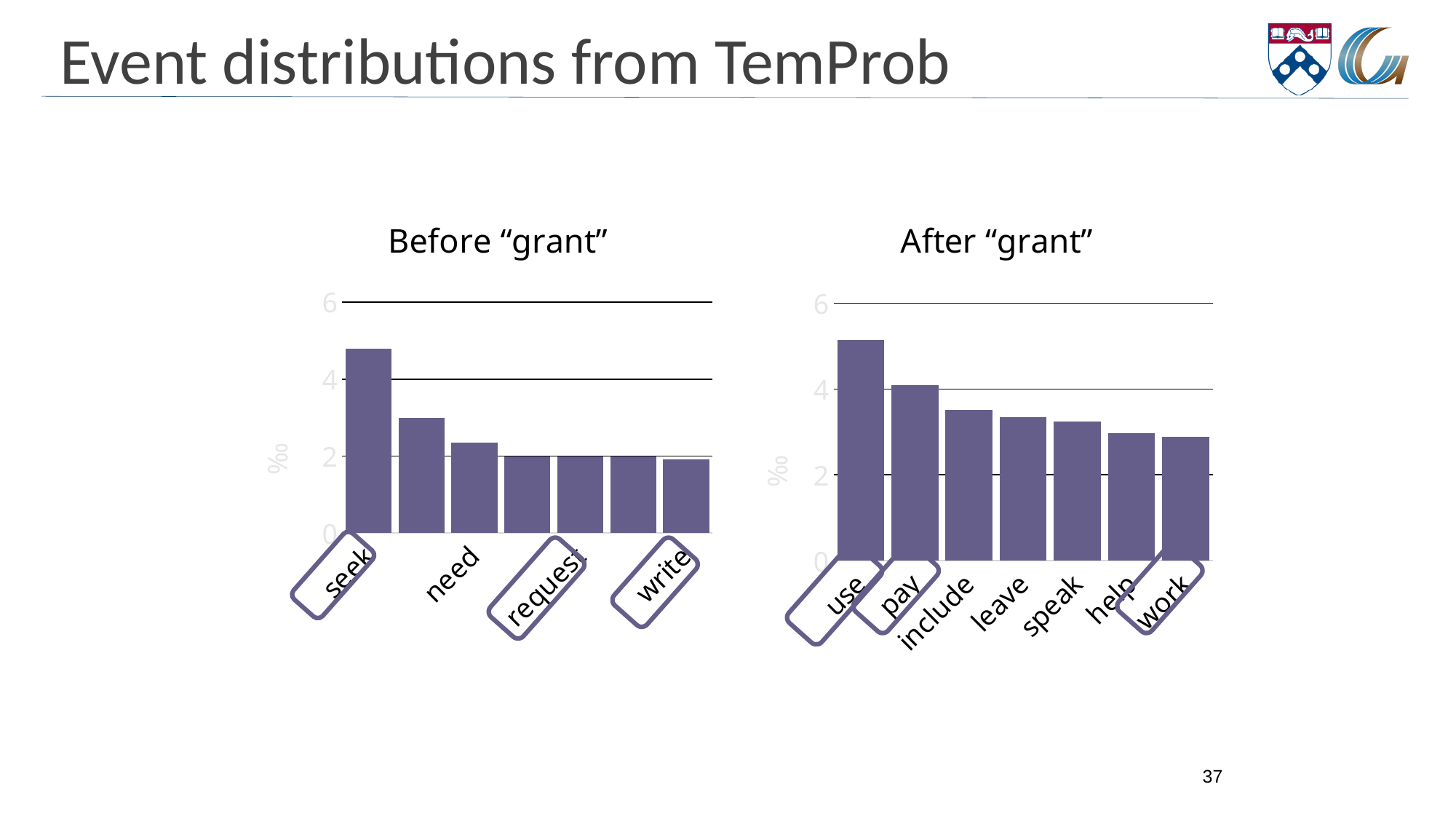
What unit is shown on the y axis of the "Before "grant"" chart? ‰ In the "After "grant"" chart, how many bars are plotted? 7 What kind of chart is the "Before "grant"" chart? bar chart In the "Before "grant"" chart, is the value for need greater or less than 4? less In the "Before "grant"" chart, is the value for seek greater or less than 4? greater In the "Before "grant"" chart, which category has the highest value? seek In the "After "grant"" chart, which is larger, the value for use or the value for work? use In the "After "grant"" chart, do the values rise or fall from left to right along the x axis? fall In the "After "grant"" chart, is the value for work greater or less than 4? less In the "After "grant"" chart, which is larger, the value for include or the value for help? include In the "After "grant"" chart, which category has the highest value? use